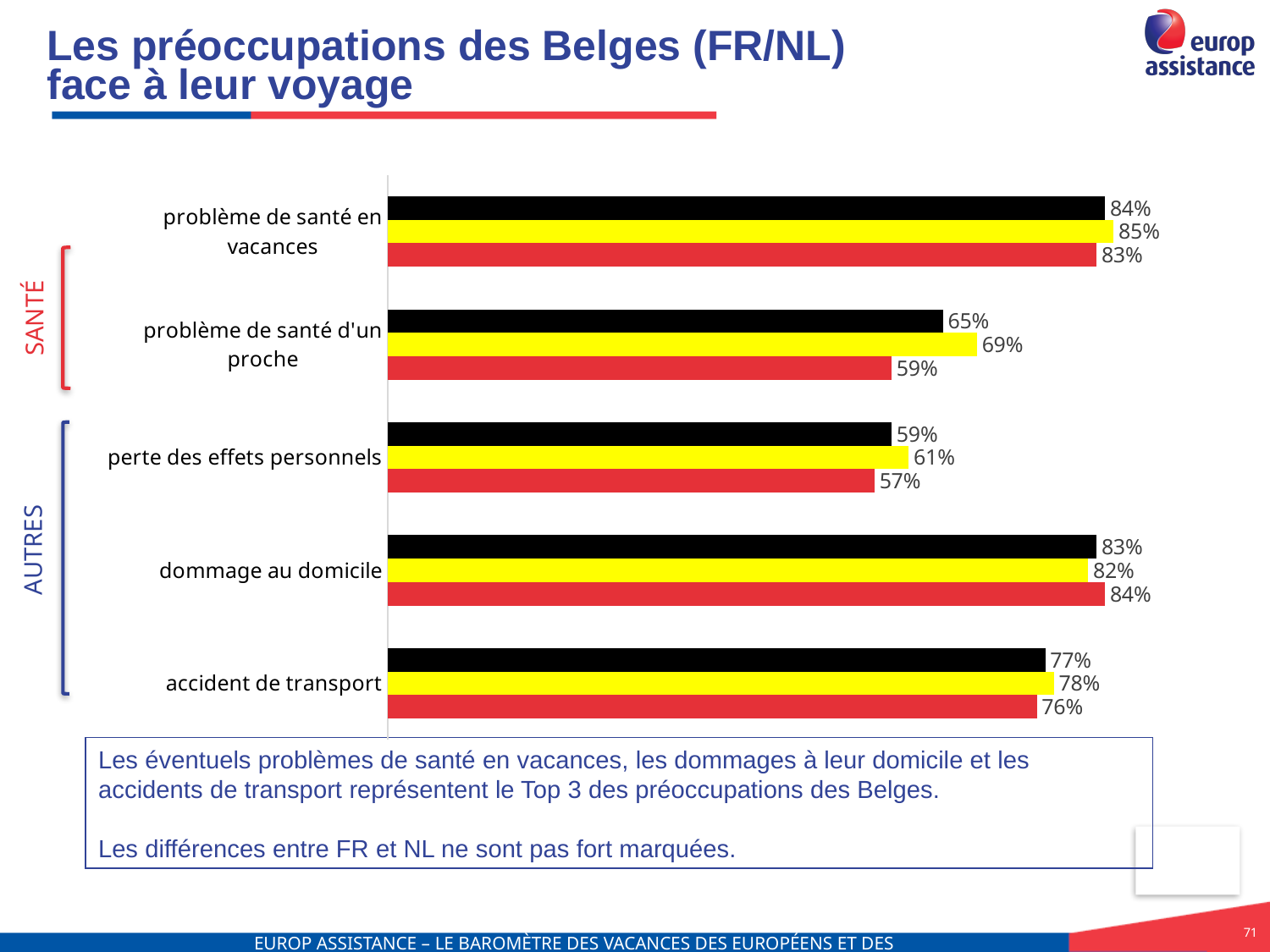
How many categories are shown on the chart? 5 Among the yellow bars, which category has the highest value? problème de santé en vacances What is the difference between the black bar for 'problème de santé en vacances' and the black bar for 'perte des effets personnels'? 25 percentage points For 'problème de santé d'un proche', what is the difference between the yellow bar and the red bar? 10 percentage points What value is shown for the yellow bar for 'problème de santé d'un proche'? 69% What value is shown for the red bar for 'dommage au domicile'? 84% What value is shown for the black bar for 'accident de transport'? 77% What kind of chart is shown on the slide? bar chart How many bars are shown for each category? 3 What value is shown for the red bar for 'perte des effets personnels'? 57% Among the red bars, which category has the lowest value? perte des effets personnels Which has the larger black bar: 'dommage au domicile' or 'accident de transport'? dommage au domicile